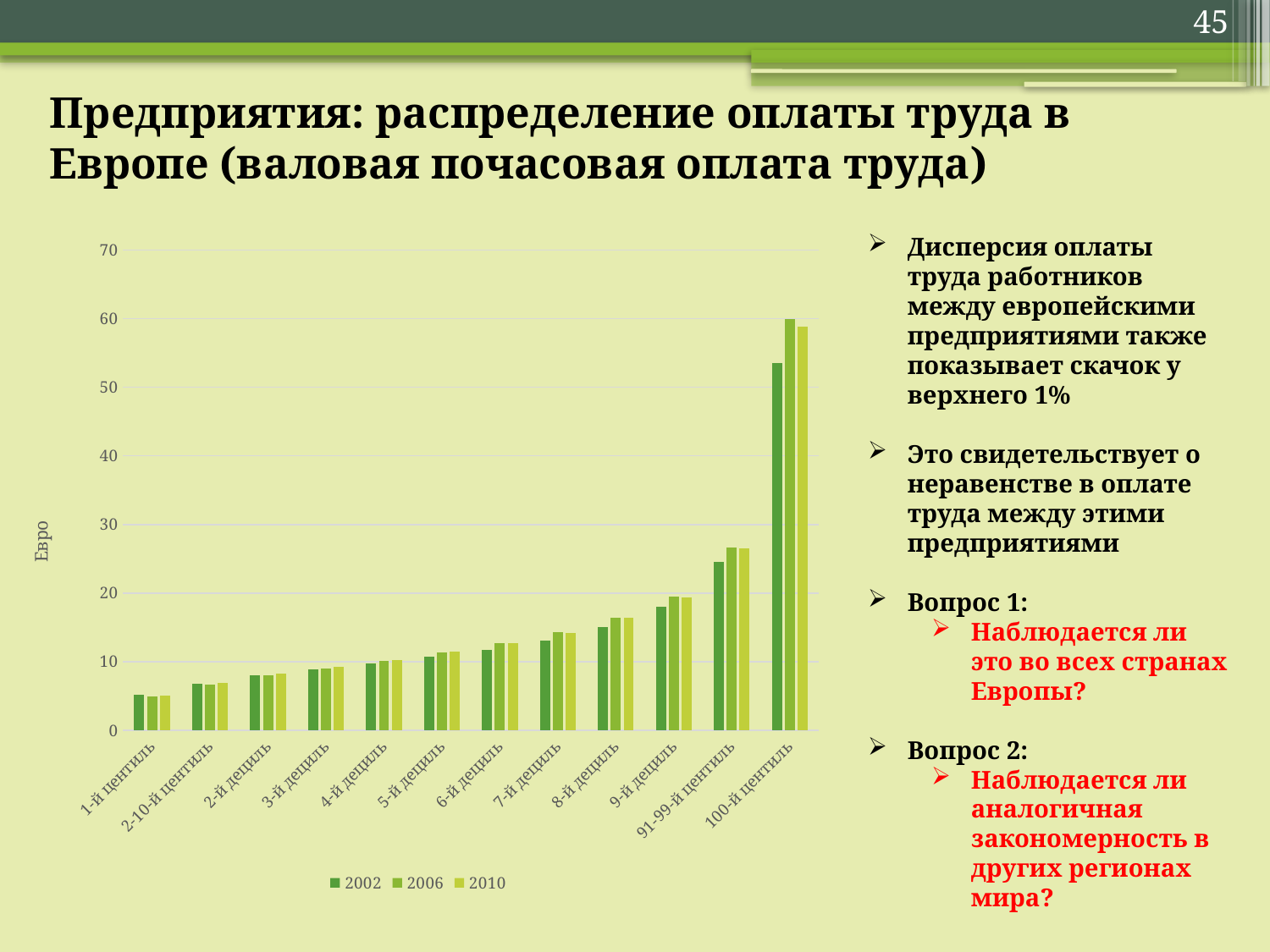
For 100-й центиль, which is larger: the 2002 value or the 2006 value? 2006 Is the 2010 value for 91-99-й центиль greater or less than 20? greater How many categories are shown on the x axis? 12 How many series does the legend list? 3 What is the label of the vertical axis? Евро Do the values rise or fall moving from left to right along the x axis? rise What kind of chart is shown on the slide? bar chart Is the 2006 value for 100-й центиль greater or less than 50? greater Is the 2010 value for 9-й дециль greater or less than 30? less Which category has the highest bars? 100-й центиль Which category has the lowest bars? 1-й центиль